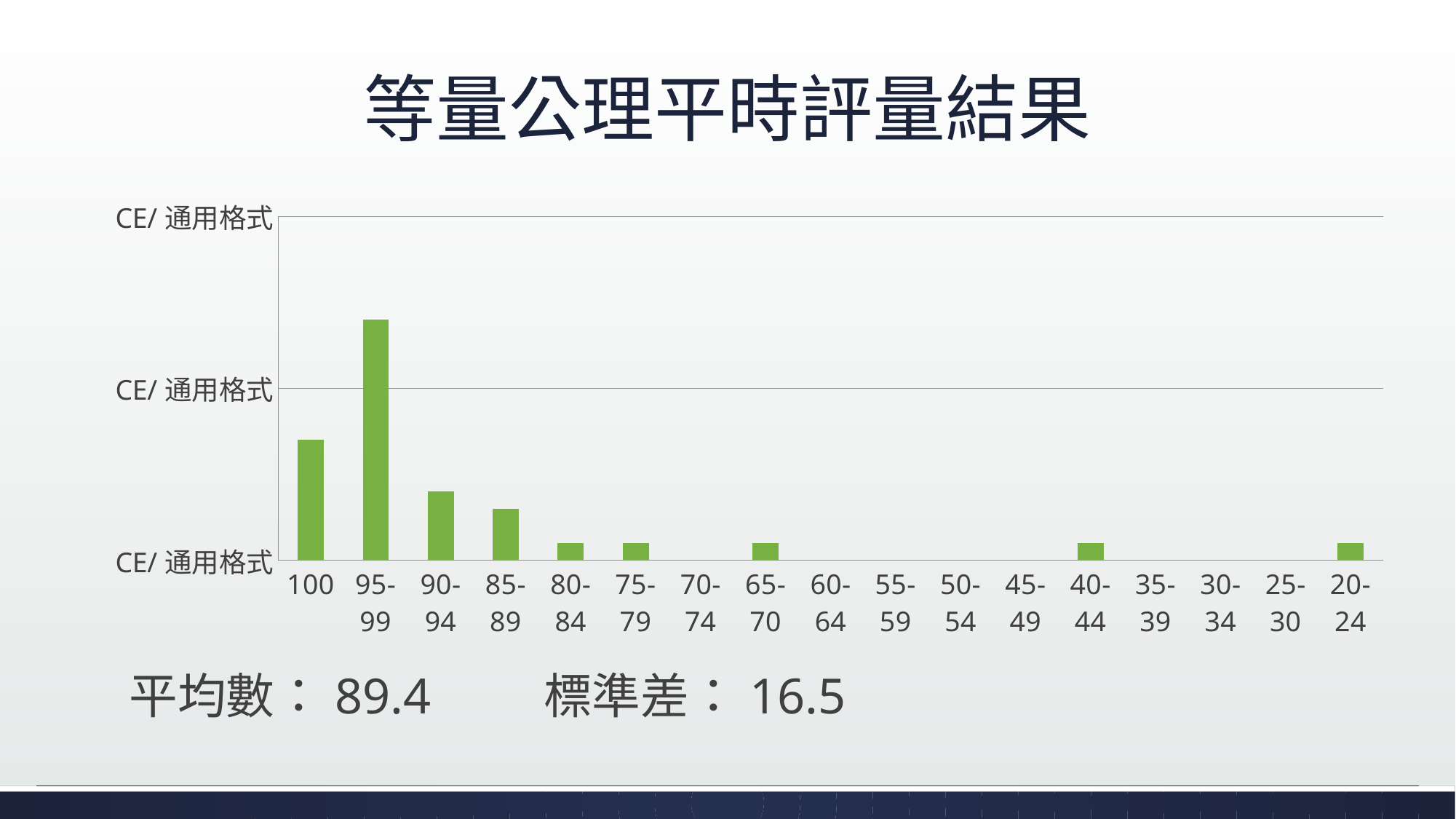
What kind of chart is shown on the slide? bar chart Which is larger, the bar for 90-94 or the bar for 80-84? 90-94 Among the categories 100, 95-99, 90-94 and 85-89, which has the lowest bar? 85-89 How many categories are shown on the x axis of the chart? 17 What mean (平均數) is stated below the chart? 89.4 Which is larger, the bar for 100 or the bar for 90-94? 100 Do the bar heights rise or fall moving along the x axis from 95-99 to 80-84? fall Which category has the tallest bar in the chart? 95-99 Which is larger, the bar for 95-99 or the bar for 85-89? 95-99 How many categories in the chart have a visible bar? 9 What is the title of the slide containing the chart? 等量公理平時評量結果